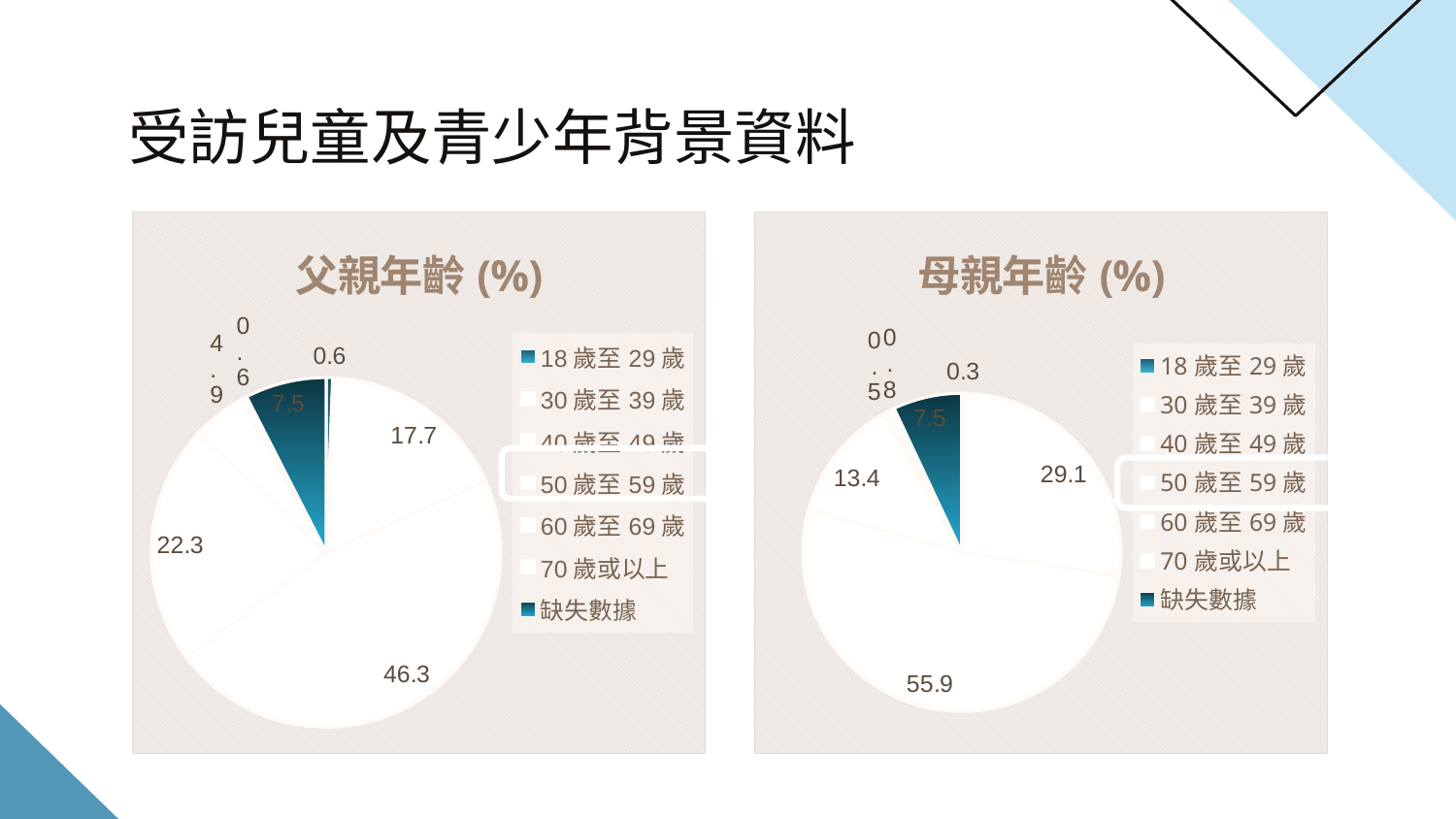
What kind of chart is the 父親年齡 (%) chart? pie chart In the 母親年齡 (%) chart, what is the value for 40 歲至 49 歲? 55.9 In the 父親年齡 (%) chart, what is the value for 50 歲至 59 歲? 22.3 What is the title of the chart on the right side of the slide? 母親年齡 (%) Which is larger in the 父親年齡 (%) chart: the share for 30 歲至 39 歲 or for 50 歲至 59 歲? 50 歲至 59 歲 In the 母親年齡 (%) chart, which age group has the largest share? 40 歲至 49 歲 In the 父親年齡 (%) chart, what is the value for 缺失數據? 7.5 In the 母親年齡 (%) chart, what is the value for 30 歲至 39 歲? 29.1 What is the difference between the 40 歲至 49 歲 value in the 母親年齡 (%) chart and the 40 歲至 49 歲 value in the 父親年齡 (%) chart? 9.6 In the 父親年齡 (%) chart, which age group has the largest share? 40 歲至 49 歲 How many entries does the legend of the 母親年齡 (%) chart list? 7 In the 父親年齡 (%) chart, what is the value for 40 歲至 49 歲? 46.3